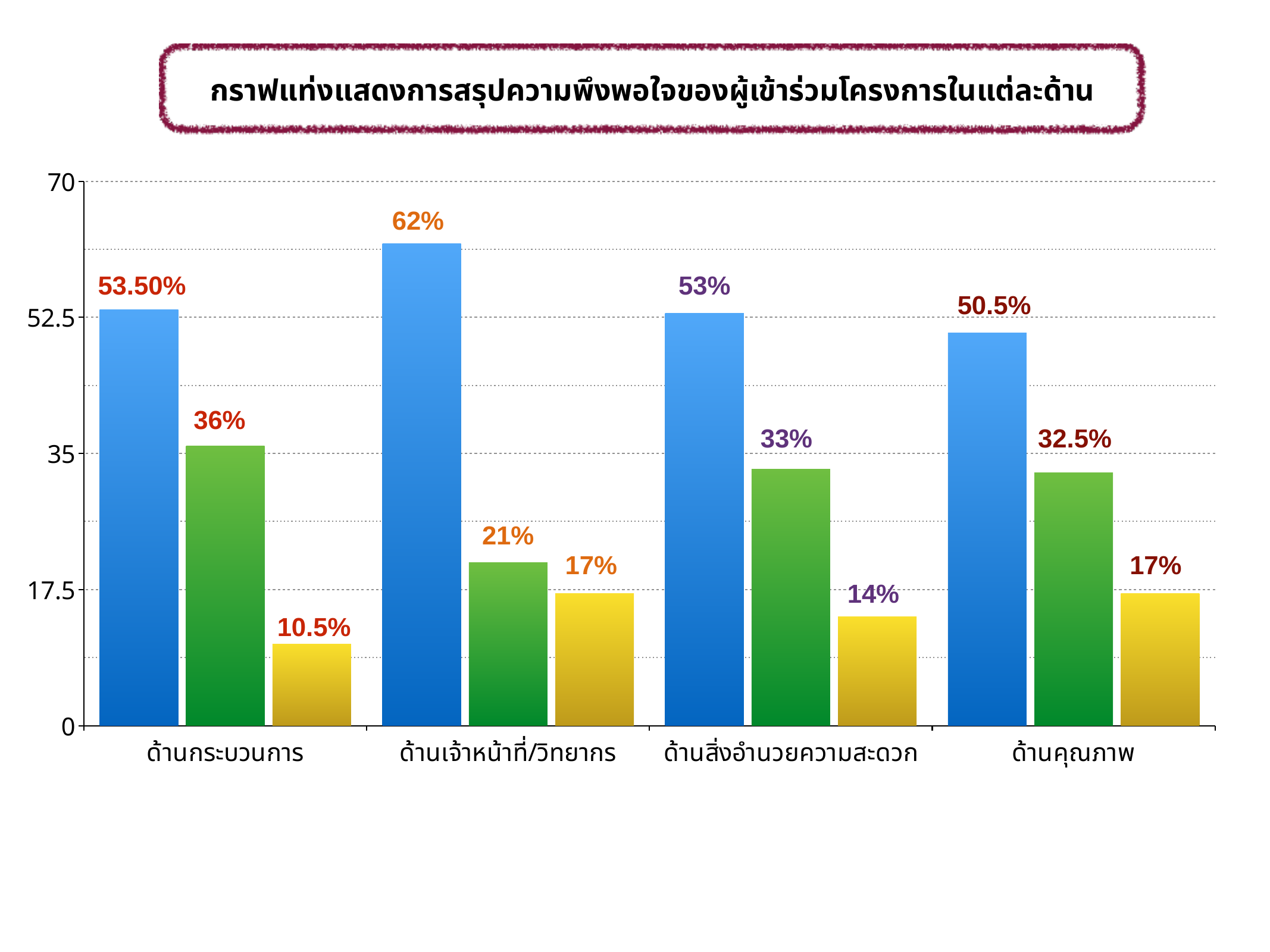
Which category has the highest blue bar? ด้านเจ้าหน้าที่/วิทยากร What is the value of the blue bar for ด้านกระบวนการ? 53.50% How many categories are shown on the x axis? 4 Which is larger: the green bar for ด้านกระบวนการ or the green bar for ด้านเจ้าหน้าที่/วิทยากร? ด้านกระบวนการ Which category has the lowest yellow bar? ด้านกระบวนการ What kind of chart is shown on the slide? bar chart What is the value of the green bar for ด้านคุณภาพ? 32.5% What is the title of the chart? กราฟแท่งแสดงการสรุปความพึงพอใจของผู้เข้าร่วมโครงการในแต่ละด้าน What is the difference between the blue bar and the green bar for ด้านสิ่งอำนวยความสะดวก? 20% What is the value of the blue bar for ด้านเจ้าหน้าที่/วิทยากร? 62% Is the value of the blue bar for ด้านคุณภาพ greater or less than 52.5? less What is the value of the yellow bar for ด้านกระบวนการ? 10.5%